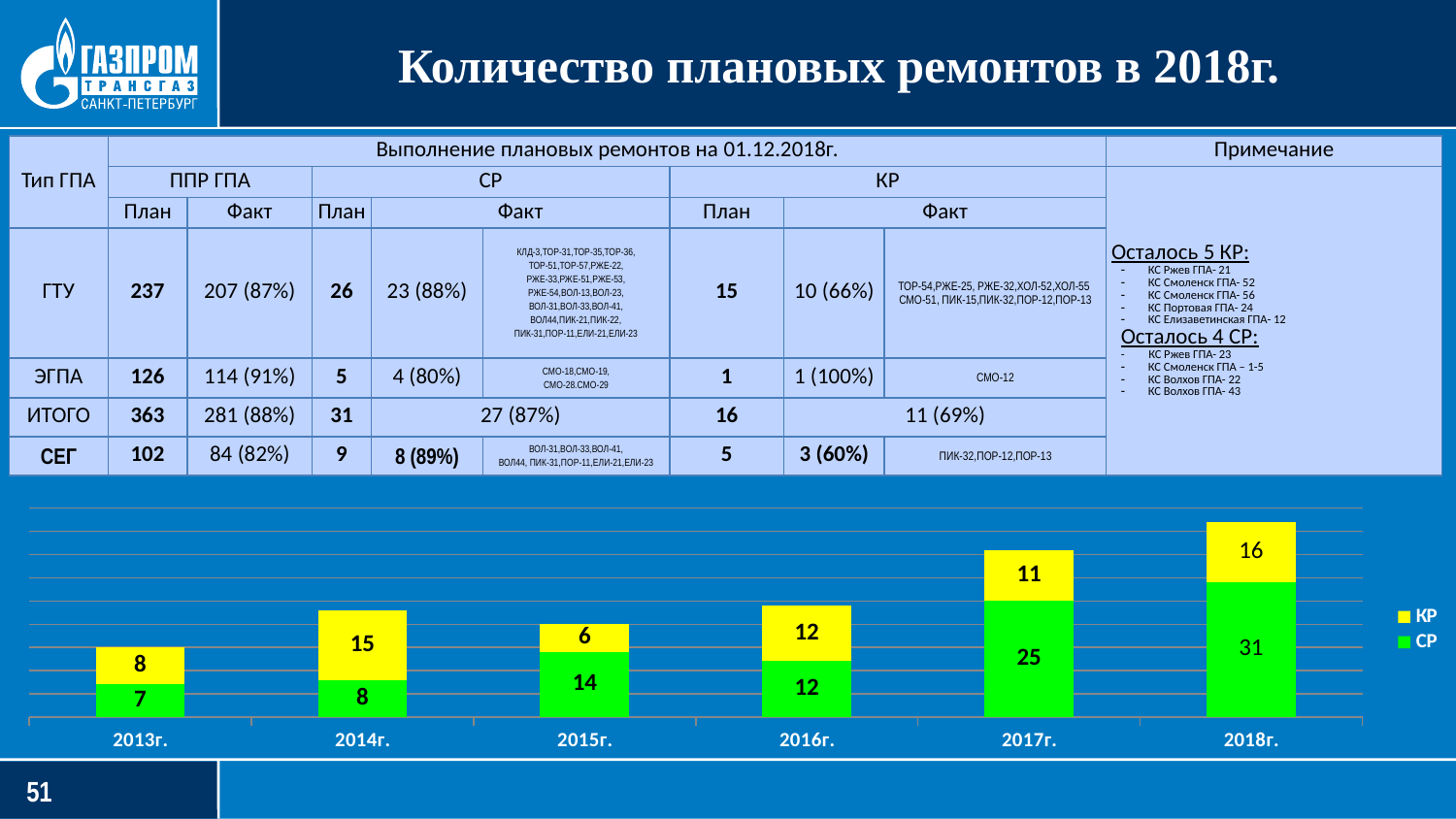
Which year has the lowest КР value in the stacked bar chart? 2015г. How many series does the legend of the stacked bar chart list? 2 What is the difference between the СР values for 2018г. and 2017г.? 6 Which is larger in 2014г.: the КР value or the СР value? КР What is the value of the СР series for 2018г. in the stacked bar chart? 31 What type of chart is shown at the bottom of the slide? Stacked bar chart What is the total of the stacked bar for 2017г.? 36 What is the total of the stacked bar for 2018г.? 47 Which year has the highest СР value in the stacked bar chart? 2018г. What is the value of the КР series for 2017г. in the stacked bar chart? 11 What is the value of the КР series for 2014г. in the stacked bar chart? 15 How many years are shown on the x axis of the stacked bar chart? 6